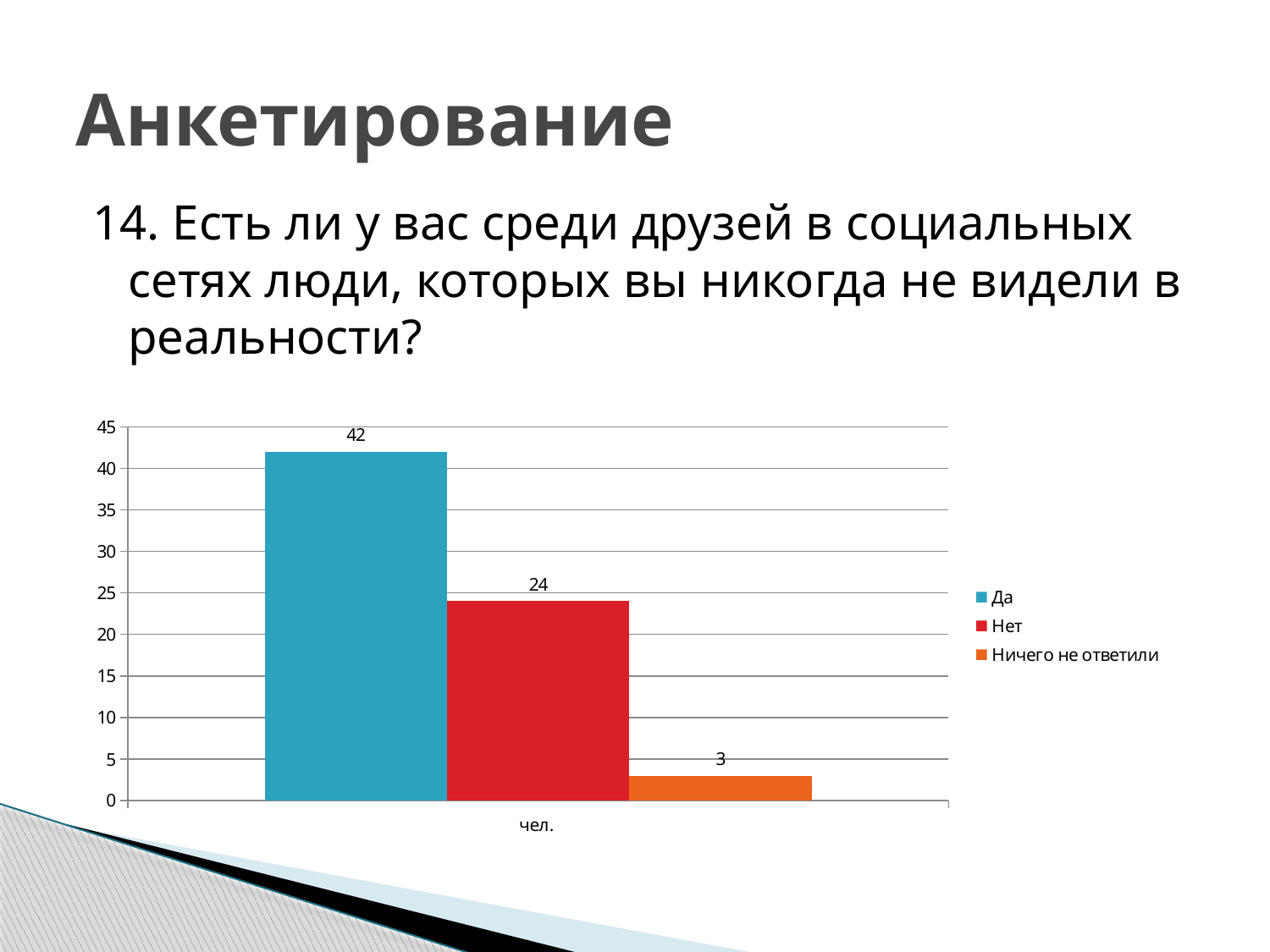
What is the value for "Нет"? 24 What is the value for "Ничего не ответили"? 3 Is the value for "Нет" greater or less than 30? less What is the difference between the values for "Нет" and "Ничего не ответили"? 21 What kind of chart is shown on the slide? bar chart What is the difference between the values for "Да" and "Нет"? 18 Which series has the highest value? Да How many series does the legend list? 3 Which series has the lowest value? Ничего не ответили What is the value for "Да"? 42 Which is larger, the value for "Да" or the value for "Нет"? Да What label is shown on the x axis of the chart? чел.